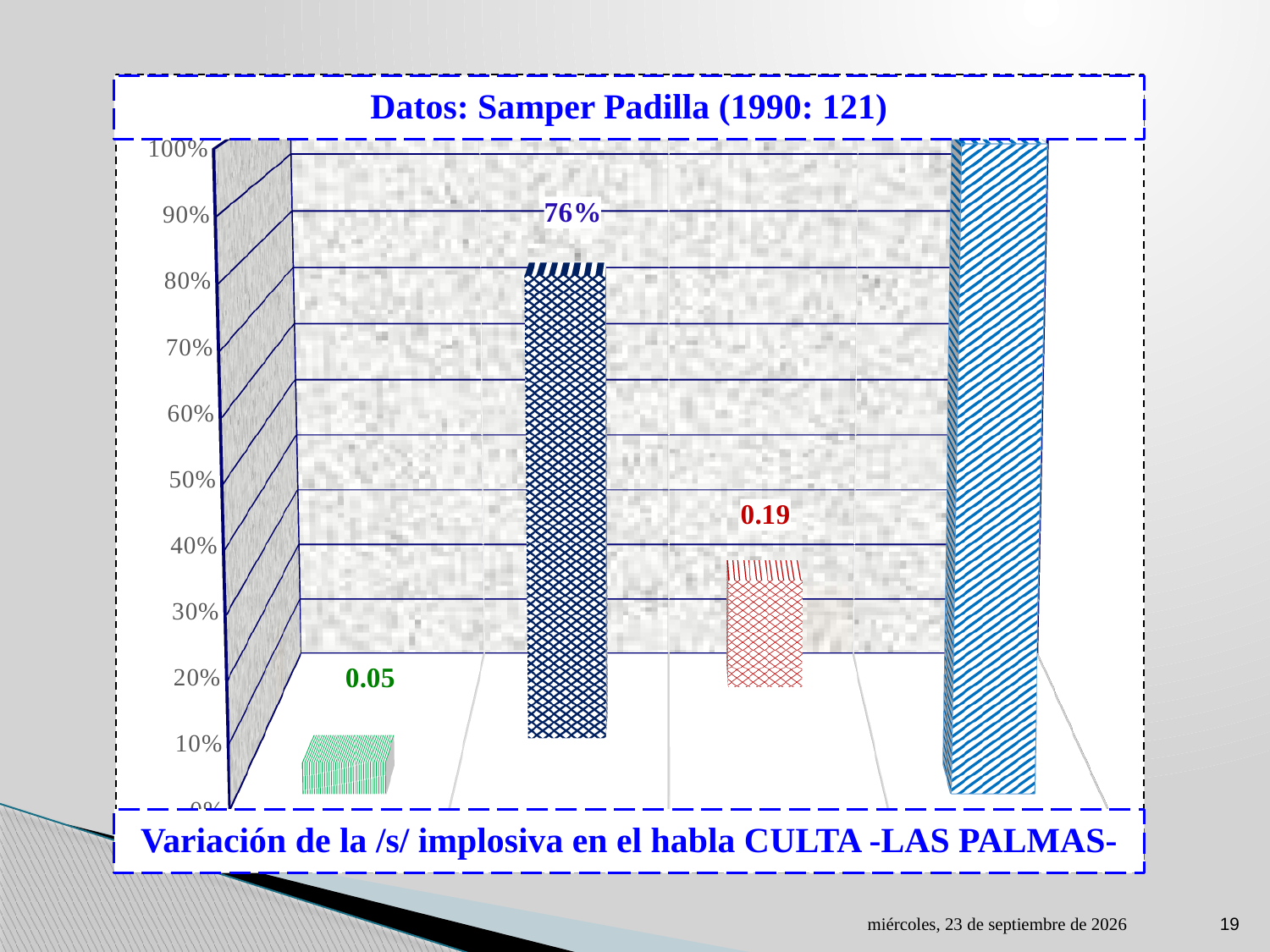
What data source is cited in the title above the chart? Datos: Samper Padilla (1990: 121) Which is larger, the value of the dark blue bar (76%) or the value of the red bar (0.19)? the dark blue bar (76%) How many bars are plotted in the chart? 4 What value is labelled on the green bar at the far left of the chart? 0.05 Is the value of the green bar at the far left greater or less than 10%? less Which bar is the tallest in the chart? the rightmost light blue striped bar What value is labelled on the dark blue crosshatched bar (second from the left)? 76% What kind of chart is shown on the slide? bar chart Is the value of the rightmost light blue striped bar greater or less than 90%? greater What value is labelled on the red crosshatched bar (third from the left)? 0.19 Which bar is the shortest in the chart? the green bar at the far left What is the difference between the labelled values of the red bar (0.19) and the green bar (0.05)? 0.14